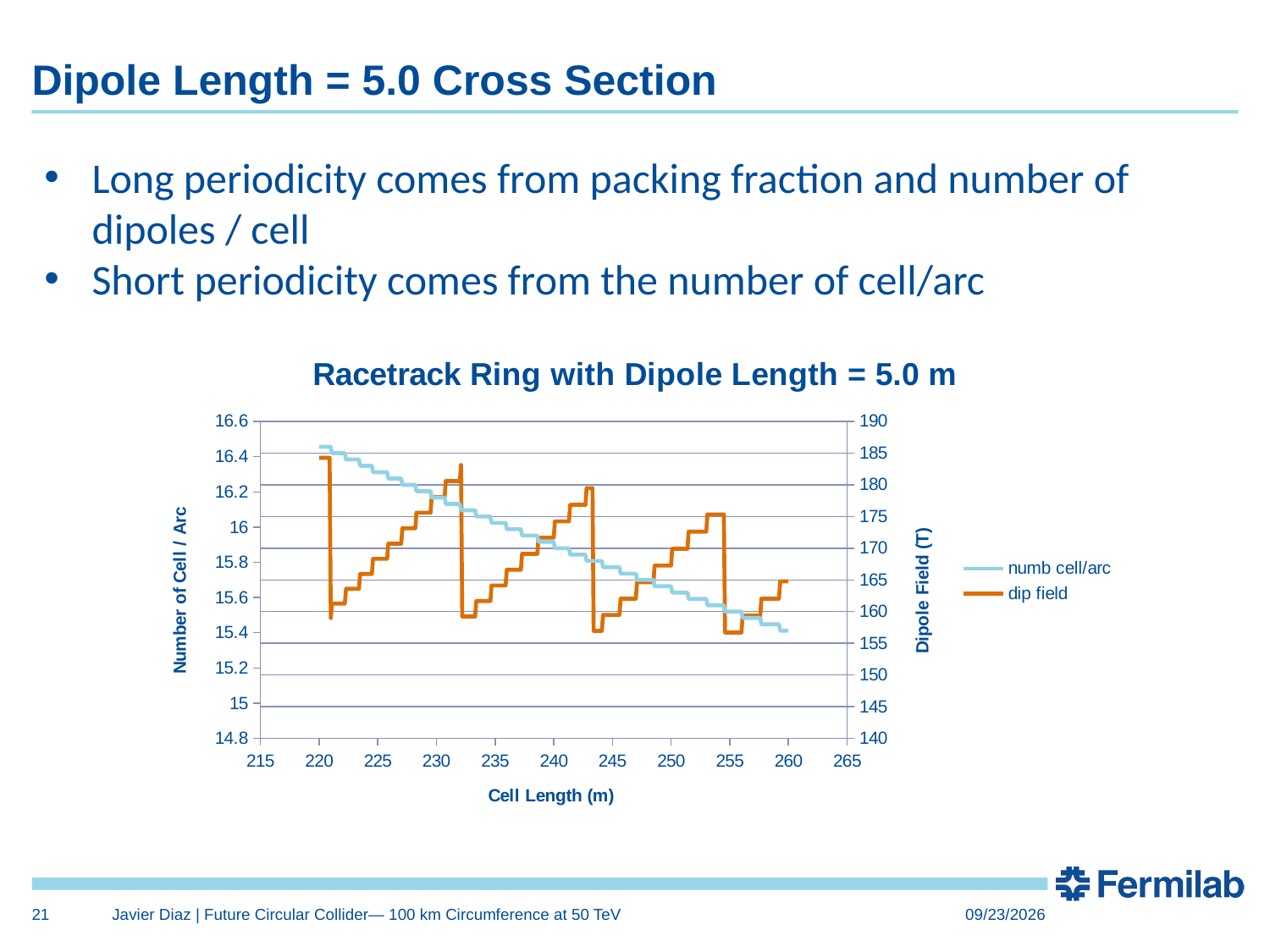
Is the value of 'numb cell/arc' at a cell length of 220 m greater or less than 16.2? greater How many series does the chart legend list? 2 What is the title of the chart? Racetrack Ring with Dipole Length = 5.0 m Is the lowest value of 'dip field' near a cell length of 255 m greater or less than 165 T? less What is the label of the x axis of the chart? Cell Length (m) Does the 'numb cell/arc' series rise or fall as cell length increases along the x axis? fall What kind of chart is shown on the slide? line chart Which series is plotted in orange according to the legend? dip field